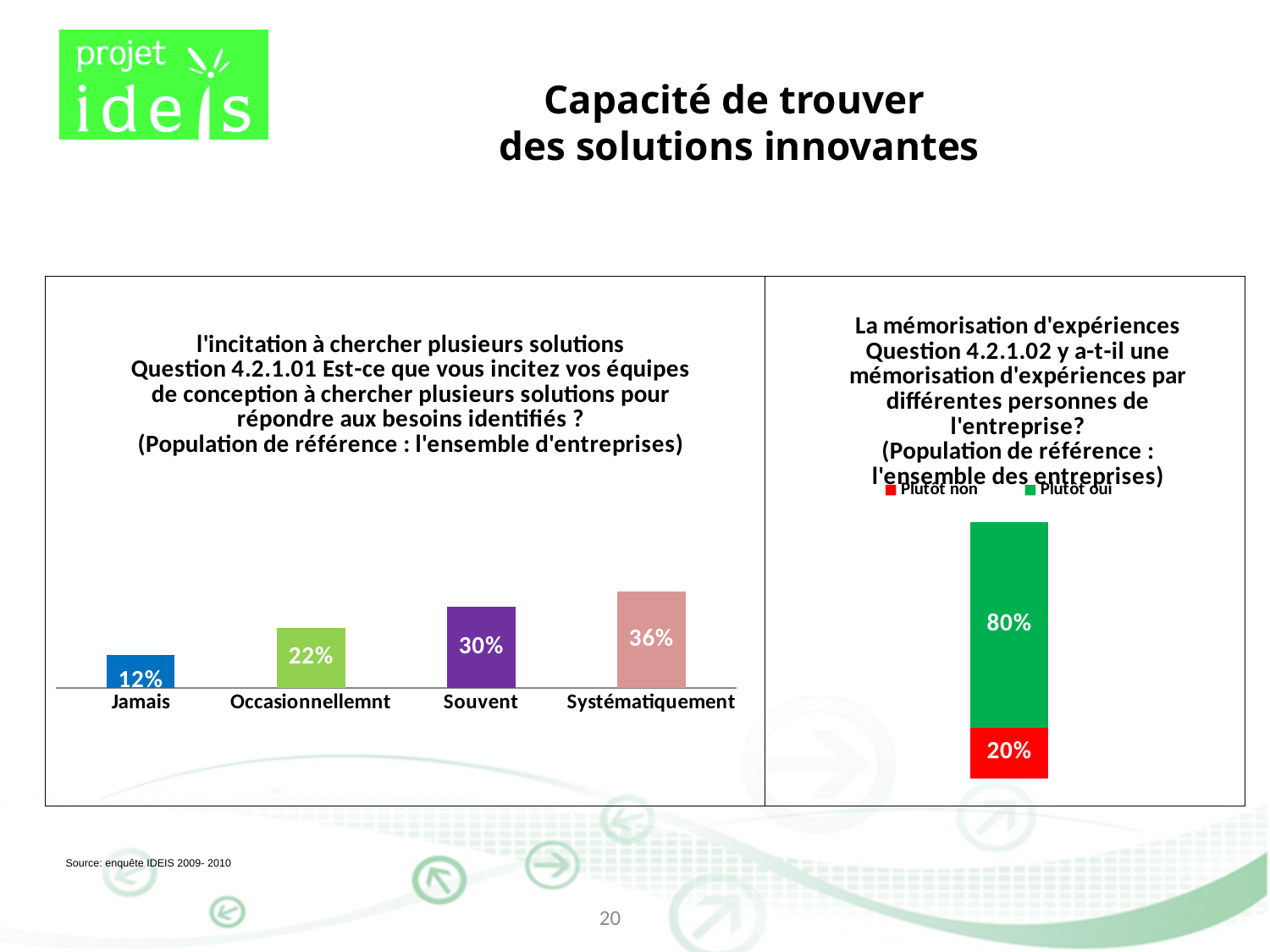
In the left chart (l'incitation à chercher plusieurs solutions), which is larger: Occasionnellemnt or Souvent? Souvent In the left chart (l'incitation à chercher plusieurs solutions), what is the value for Souvent? 30% In the left chart (l'incitation à chercher plusieurs solutions), what is the value for Jamais? 12% In the right chart (La mémorisation d'expériences), how many series does the legend list? 2 What kind of chart is the left chart (l'incitation à chercher plusieurs solutions)? bar chart In the left chart (l'incitation à chercher plusieurs solutions), how many categories are shown? 4 In the right chart (La mémorisation d'expériences), what is the value for Plutôt oui? 80% In the left chart (l'incitation à chercher plusieurs solutions), do the values rise or fall from Jamais to Systématiquement? rise In the left chart (l'incitation à chercher plusieurs solutions), which category has the highest value? Systématiquement In the left chart (l'incitation à chercher plusieurs solutions), which category has the lowest value? Jamais In the right chart (La mémorisation d'expériences), what is the value for Plutôt non? 20% In the left chart (l'incitation à chercher plusieurs solutions), what is the difference between Systématiquement and Occasionnellemnt? 14%